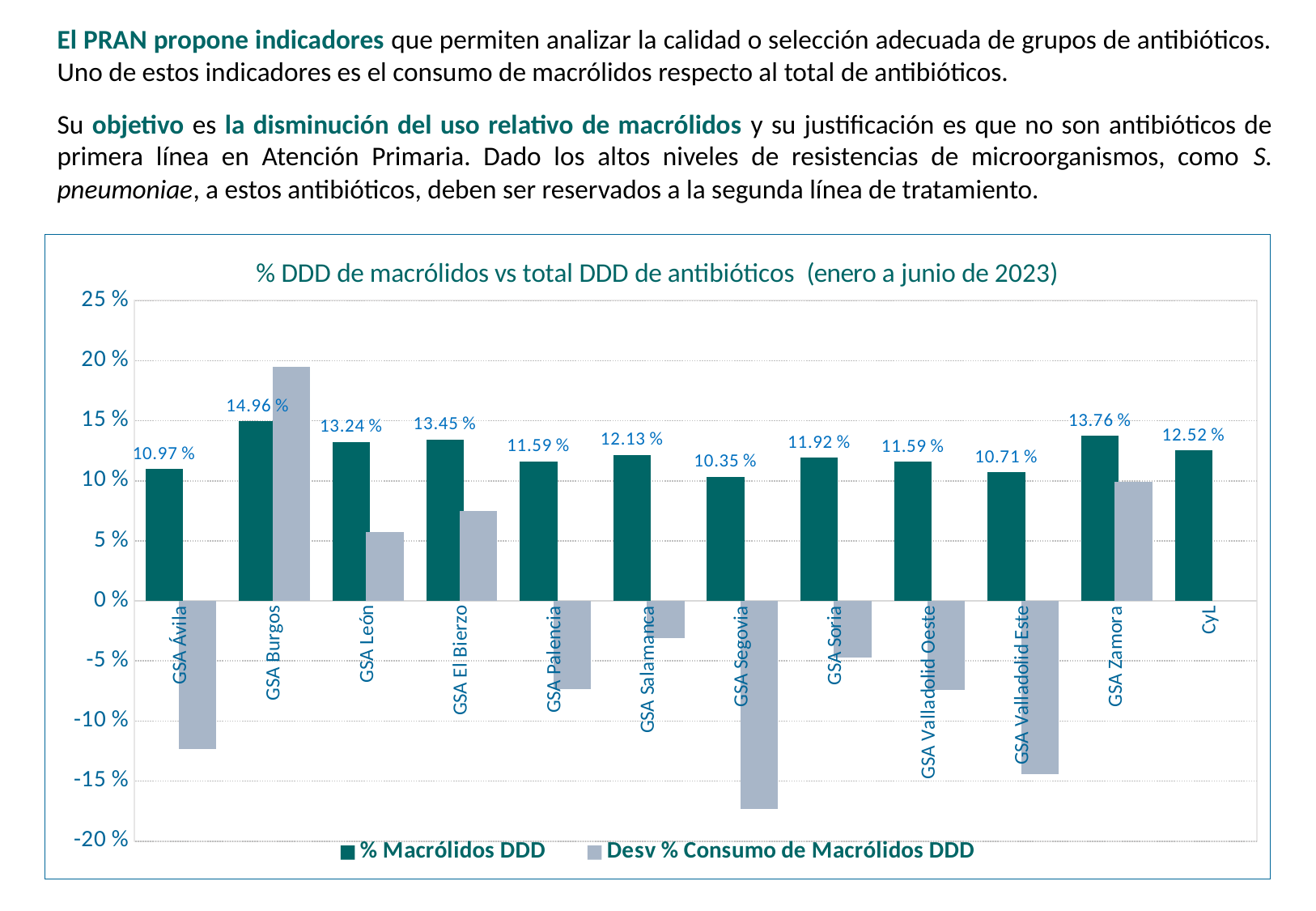
How many series does the chart legend list? 2 What is the % Macrólidos DDD value for GSA Segovia? 10.35 % Which category has the lowest % Macrólidos DDD value? GSA Segovia Is the Desv % Consumo de Macrólidos DDD value for GSA Segovia greater or less than -15 %? less What type of chart is shown on the slide? Bar chart What is the % Macrólidos DDD value for CyL? 12.52 % Which has a higher % Macrólidos DDD value, GSA Zamora or GSA León? GSA Zamora How many categories are shown on the x axis of the chart? 12 Which category has the highest % Macrólidos DDD value? GSA Burgos What is the % Macrólidos DDD value for GSA Burgos? 14.96 % What is the difference between the % Macrólidos DDD values for GSA Burgos and GSA Segovia? 4.61 % Is the Desv % Consumo de Macrólidos DDD value for GSA Burgos greater or less than 15 %? greater